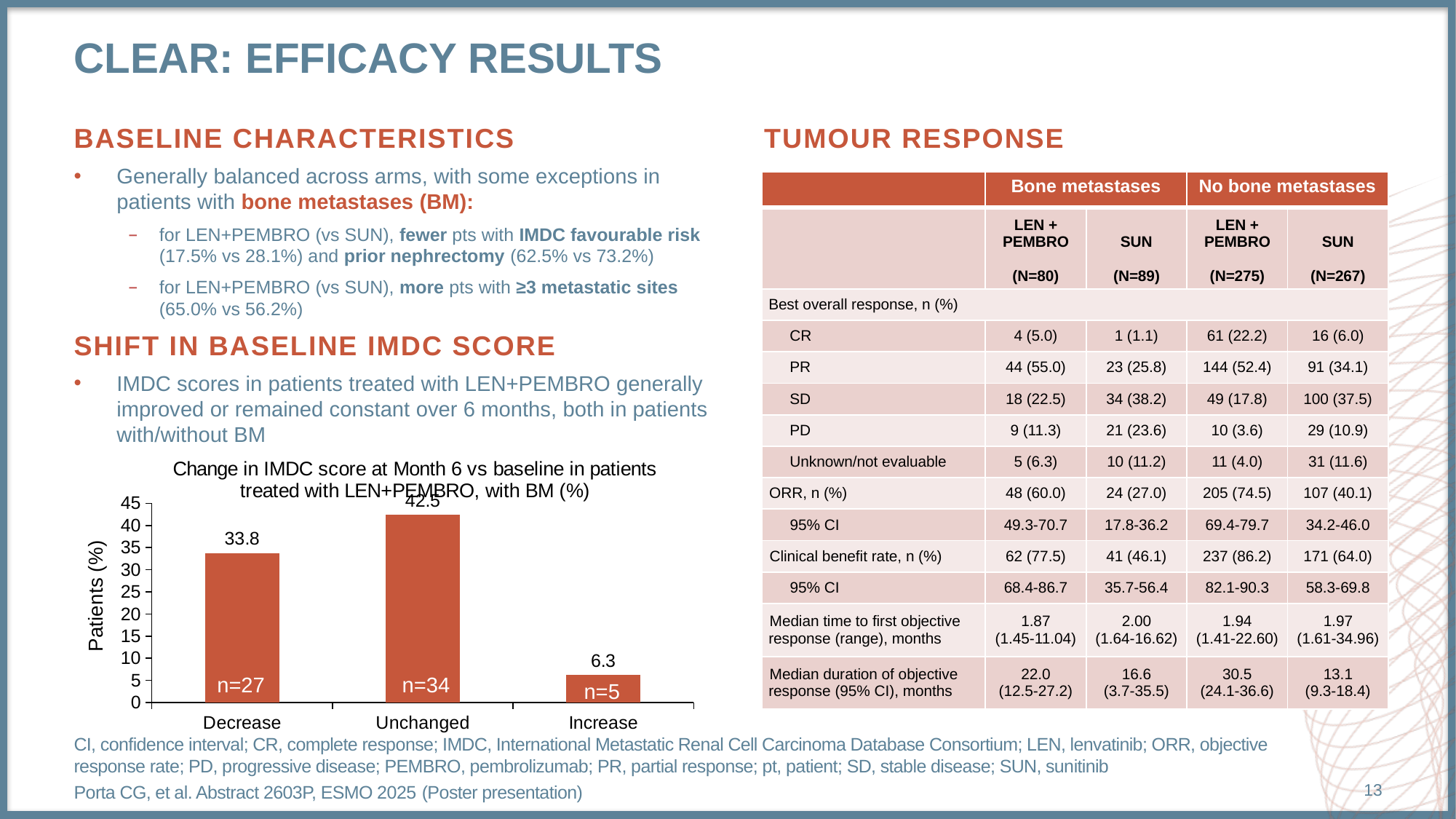
What is the difference between the values for Unchanged and Decrease? 8.7 Which category has the highest value in the chart? Unchanged What is the value for Decrease in the chart? 33.8 What kind of chart is shown on the slide? Bar chart What is the difference between the values for Decrease and Increase? 27.5 What is the number of patients (n) shown inside the Unchanged bar? n=34 What is the value for Unchanged in the chart? 42.5 Is the value for Unchanged greater or less than 40? greater Which category has the lowest value in the chart? Increase What is the value for Increase in the chart? 6.3 How many categories are shown on the x axis of the chart? 3 Which is larger, the value for Decrease or the value for Increase? Decrease